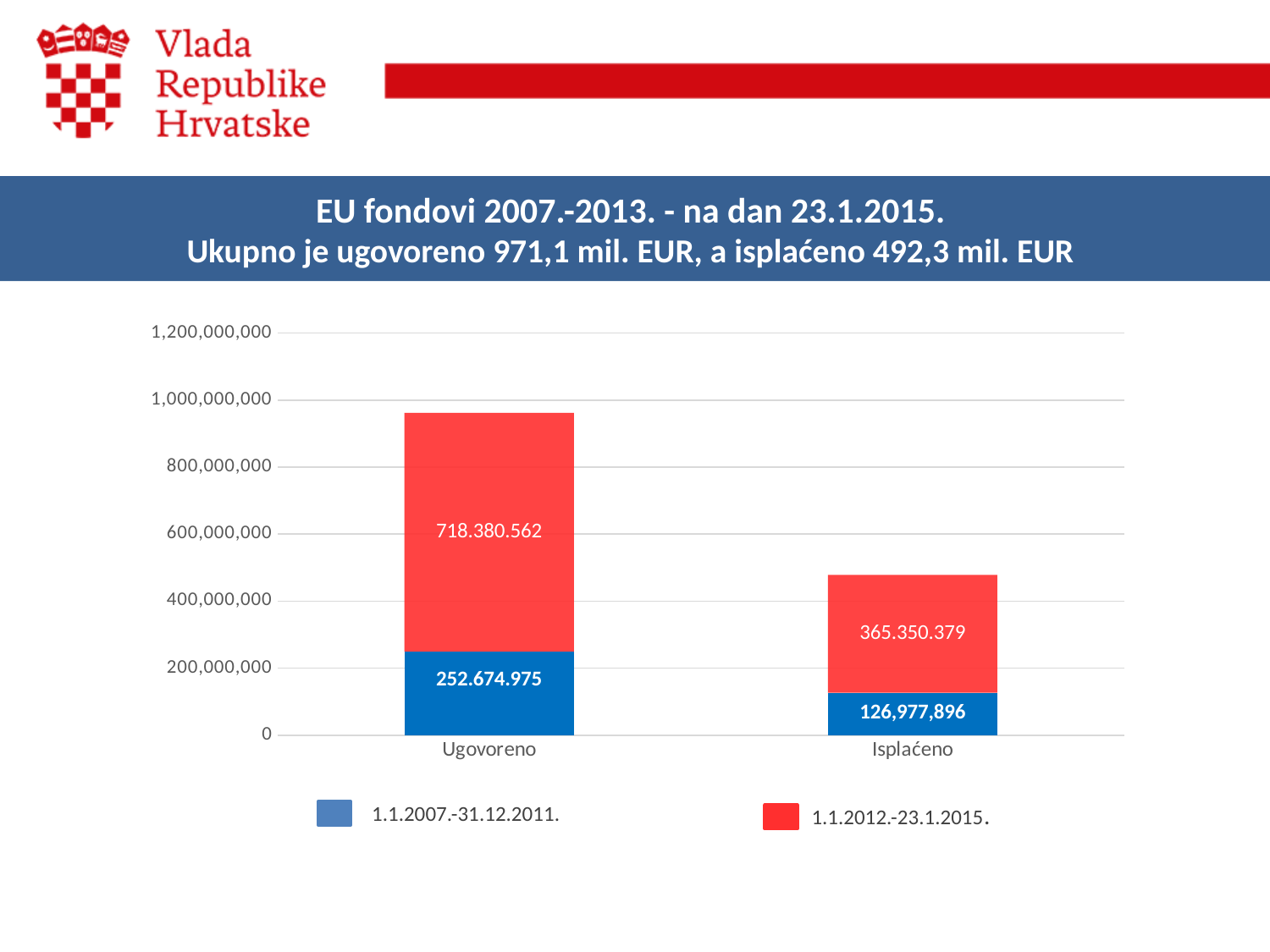
What is the value for the 1.1.2012.-23.1.2015. series in the Ugovoreno bar? 718.380.562 What is the total of the Isplaćeno stacked bar? 492,328,275 Which category has the taller stacked bar, Ugovoreno or Isplaćeno? Ugovoreno How many series does the legend list? 2 What is the value for the 1.1.2007.-31.12.2011. series in the Isplaćeno bar? 126,977,896 What is the value for the 1.1.2007.-31.12.2011. series in the Ugovoreno bar? 252.674.975 What is the value for the 1.1.2012.-23.1.2015. series in the Isplaćeno bar? 365.350.379 What is the difference between the 1.1.2012.-23.1.2015. value and the 1.1.2007.-31.12.2011. value in the Ugovoreno bar? 465,705,587 What kind of chart is shown on the slide? Stacked bar chart Is the total of the Ugovoreno bar greater or less than 800,000,000? greater Which colour represents the 1.1.2007.-31.12.2011. series? Blue What is the total of the Ugovoreno stacked bar? 971,055,537